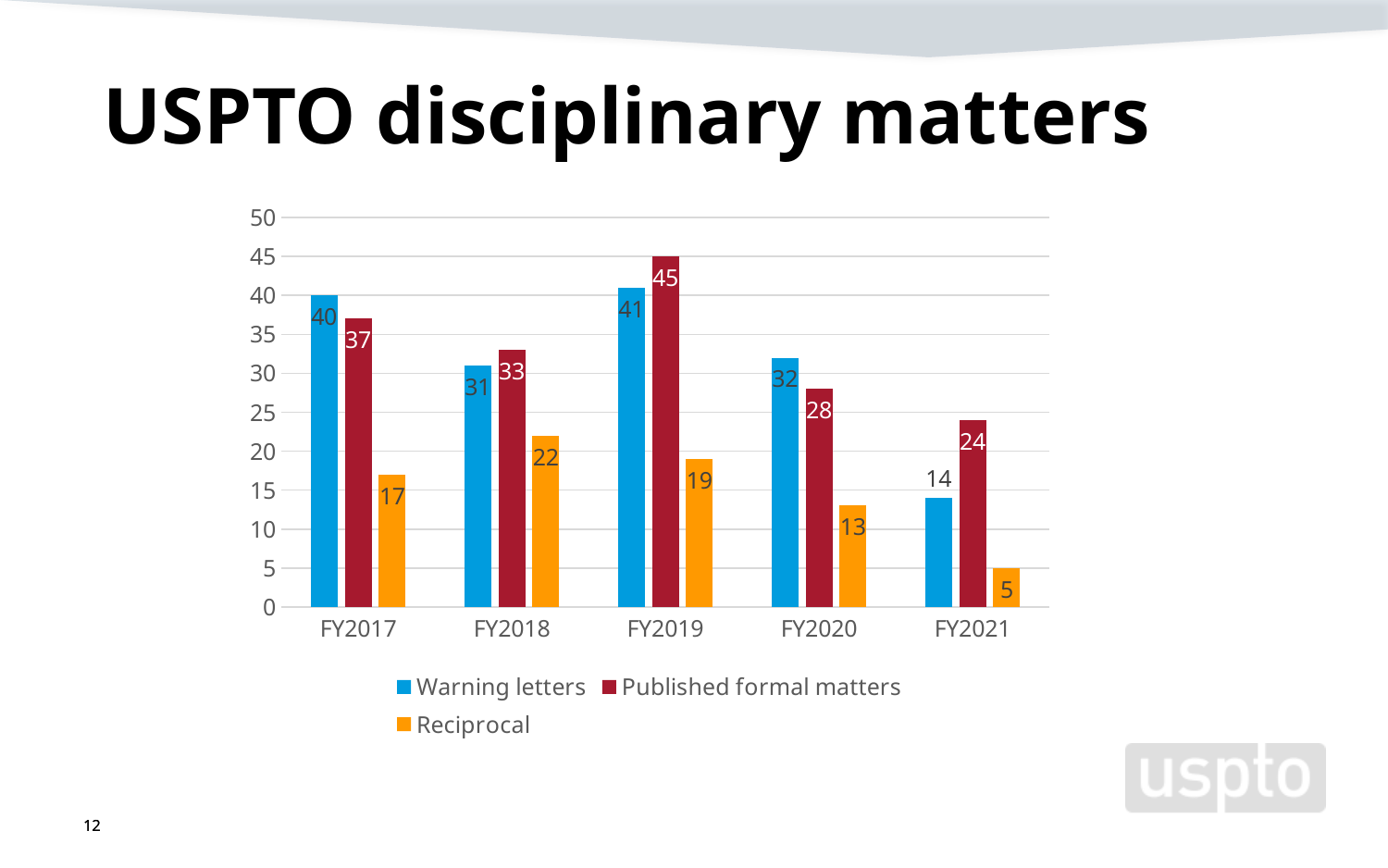
What colour represents Reciprocal in the chart? Orange What is the Reciprocal value for FY2018? 22 How many Warning letters were there in FY2019? 41 What kind of chart is shown on the slide? Bar chart Do the Reciprocal values rise or fall from FY2018 to FY2021? Fall How many series does the legend list? 3 How many fiscal years are shown on the x axis? 5 In which fiscal year was the Reciprocal value lowest? FY2021 Which is larger in FY2017: Warning letters or Published formal matters? Warning letters What is the value for Published formal matters in FY2021? 24 In which fiscal year were Published formal matters highest? FY2019 What is the difference between Warning letters and Published formal matters in FY2020? 4